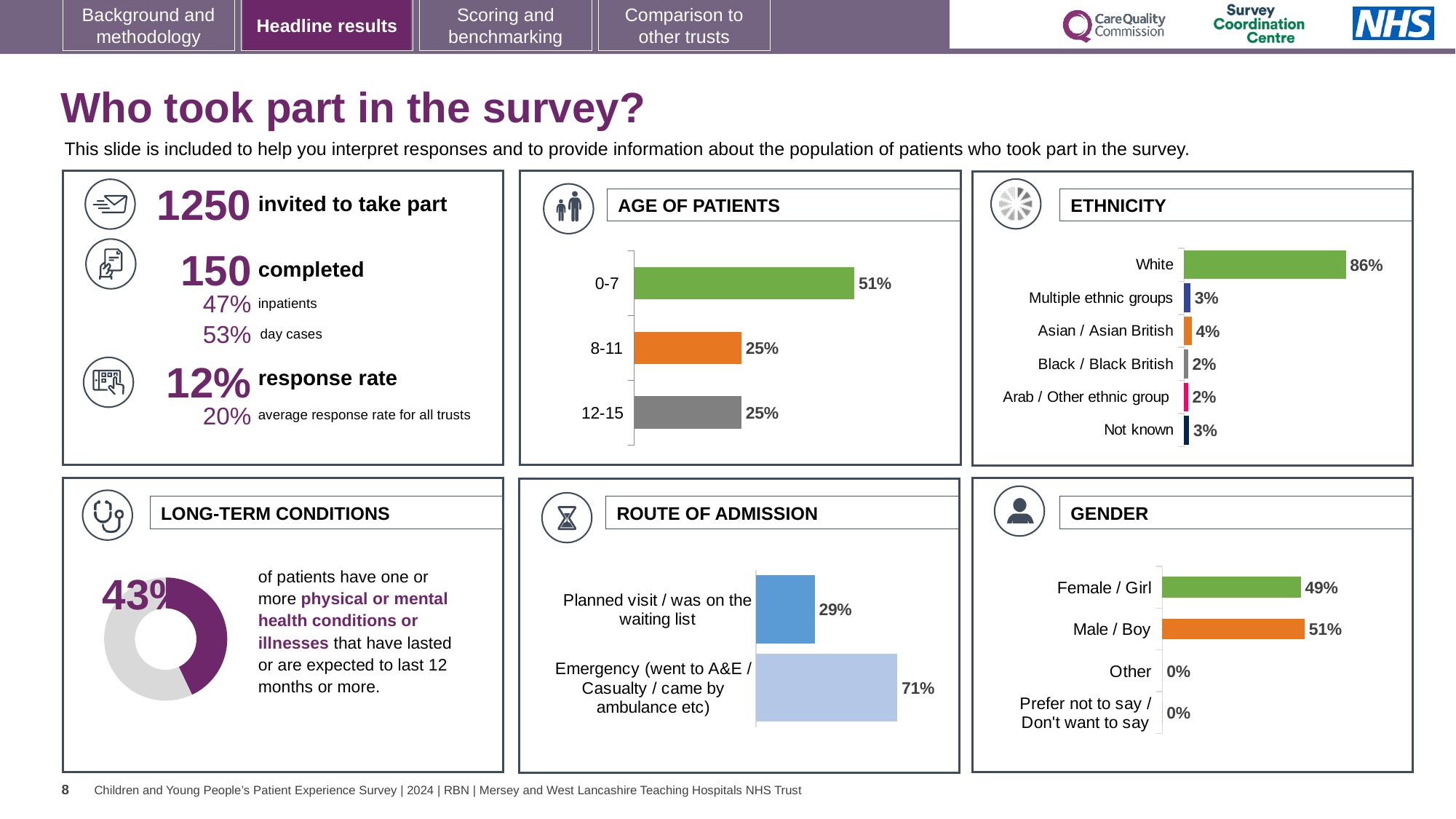
In the AGE OF PATIENTS chart, which age group has the highest value? 0-7 In the AGE OF PATIENTS chart, what percentage of patients were aged 0-7? 51% In the ETHNICITY chart, what is the difference between the White and Asian / Asian British values? 82% In the ROUTE OF ADMISSION chart, what percentage of patients came via Emergency (went to A&E / Casualty / came by ambulance etc)? 71% In the ETHNICITY chart, what percentage of patients were White? 86% What kind of chart is used in the LONG-TERM CONDITIONS panel? Doughnut chart In the AGE OF PATIENTS chart, how many age groups are shown? 3 In the ETHNICITY chart, how many ethnicity categories are listed? 6 In the GENDER chart, what is the difference between the Male / Boy and Female / Girl values? 2% In the LONG-TERM CONDITIONS chart, what percentage of patients have one or more long-term conditions? 43% In the ROUTE OF ADMISSION chart, which route has the lower value? Planned visit / was on the waiting list In the GENDER chart, what percentage of patients were Male / Boy? 51%